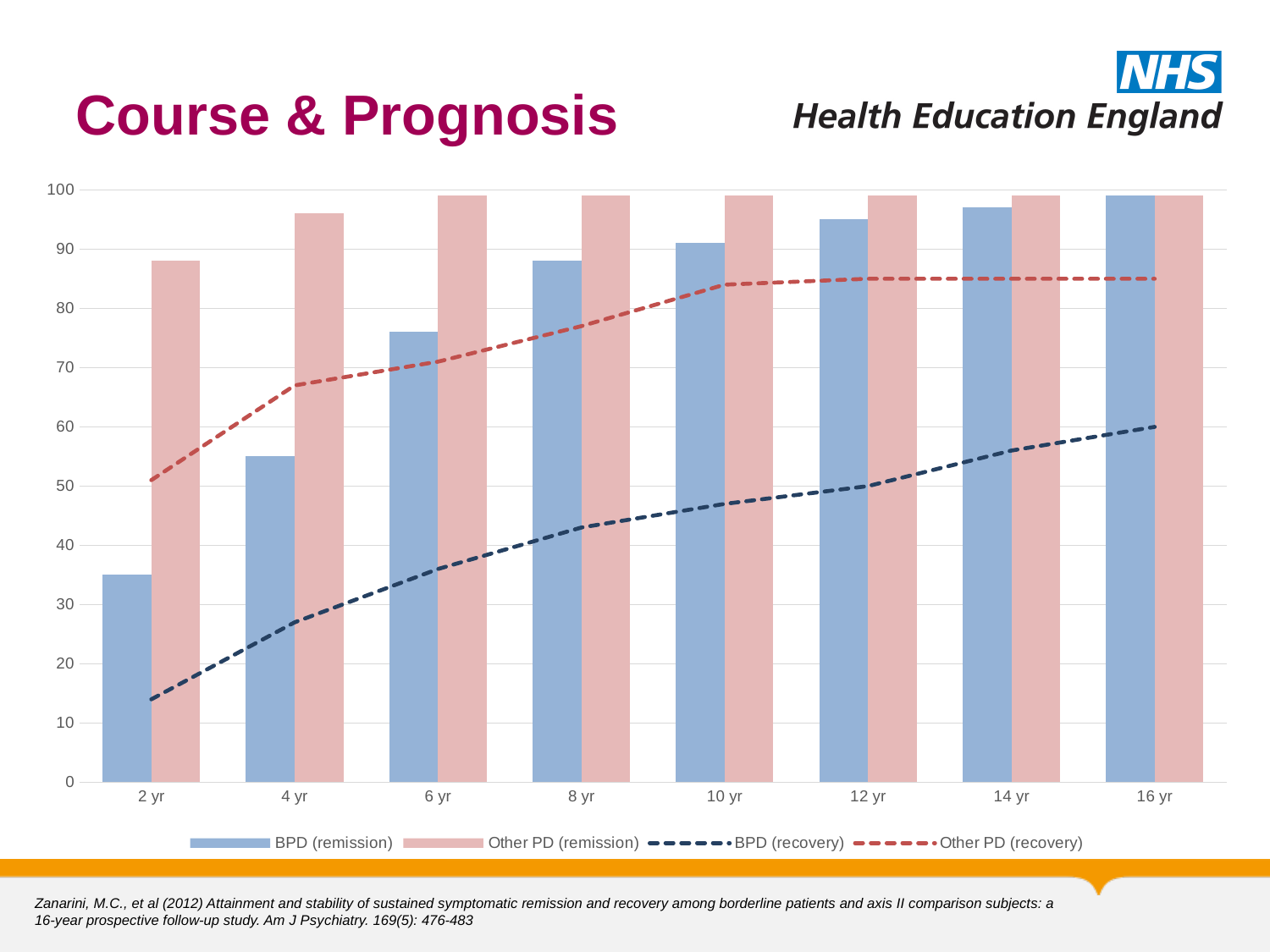
At which time point is BPD (remission) lowest? 2 yr What kind of chart is shown on the slide? A combined bar and line chart How many series does the legend list? 4 Is the value for Other PD (recovery) at 10 yr greater or less than 80? greater How many time points are shown on the x axis? 8 Which series is drawn as a red dashed line? Other PD (recovery) Is the value for BPD (recovery) at 2 yr greater or less than 20? less Is the value for Other PD (remission) at 2 yr greater or less than 80? greater At 4 yr, which is larger: BPD (remission) or Other PD (remission)? Other PD (remission) Does the BPD (recovery) line rise or fall from 2 yr to 16 yr? rises